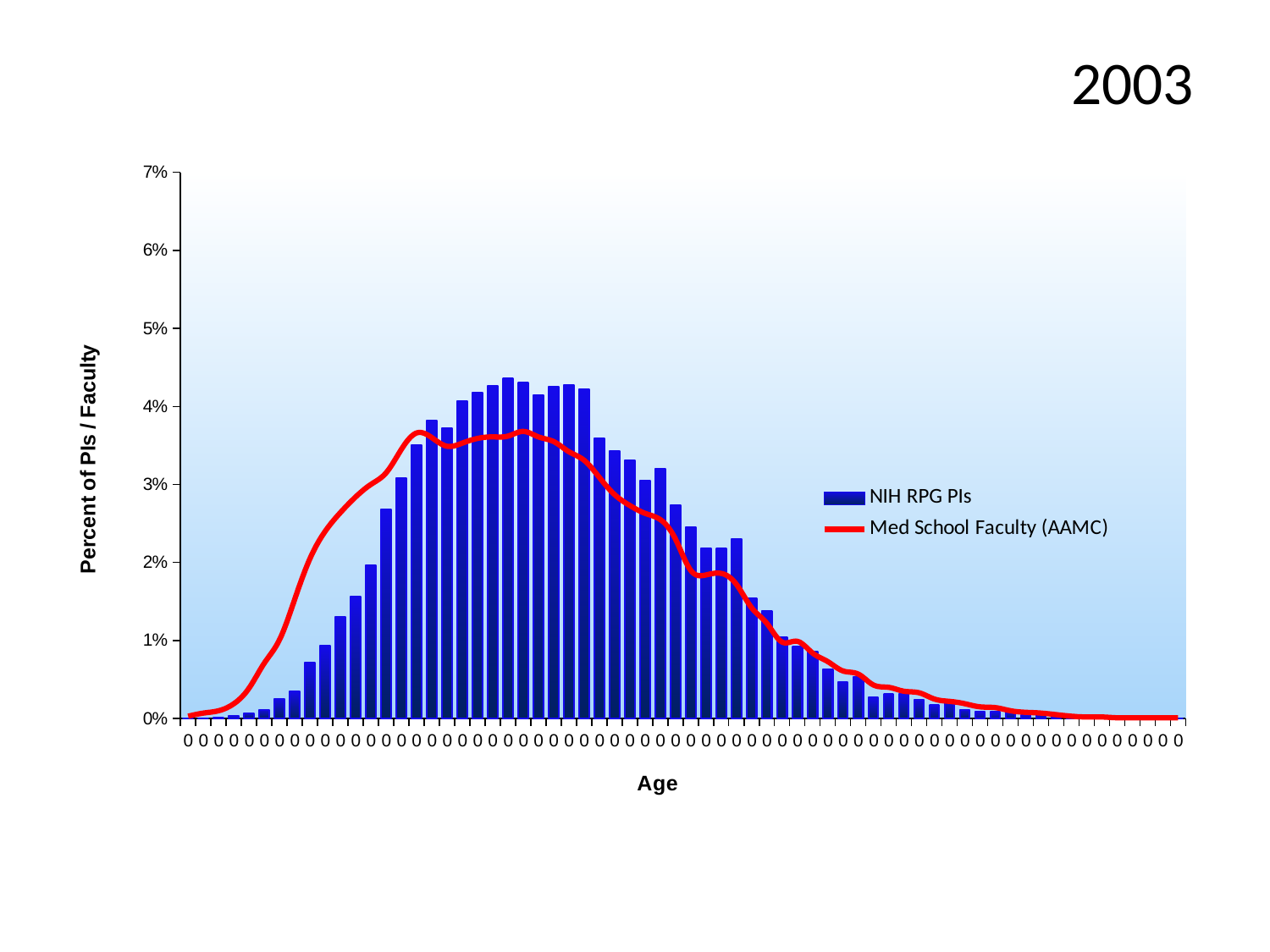
Which series is drawn as a red line? Med School Faculty (AAMC) Which series is drawn as blue bars? NIH RPG PIs What is the highest value shown on the y axis? 7% What kind of chart is shown on the slide? A bar chart with a line overlay Is the tallest NIH RPG PIs bar greater or less than 4%? greater What year is shown as the slide title? 2003 What is the label of the y axis? Percent of PIs / Faculty How many series does the legend list? 2 Is the peak of the Med School Faculty (AAMC) line greater or less than 4%? less Do the NIH RPG PIs bars rise or fall along the right half of the x axis? fall Is the tallest NIH RPG PIs bar greater or less than 5%? less What is the label of the x axis? Age